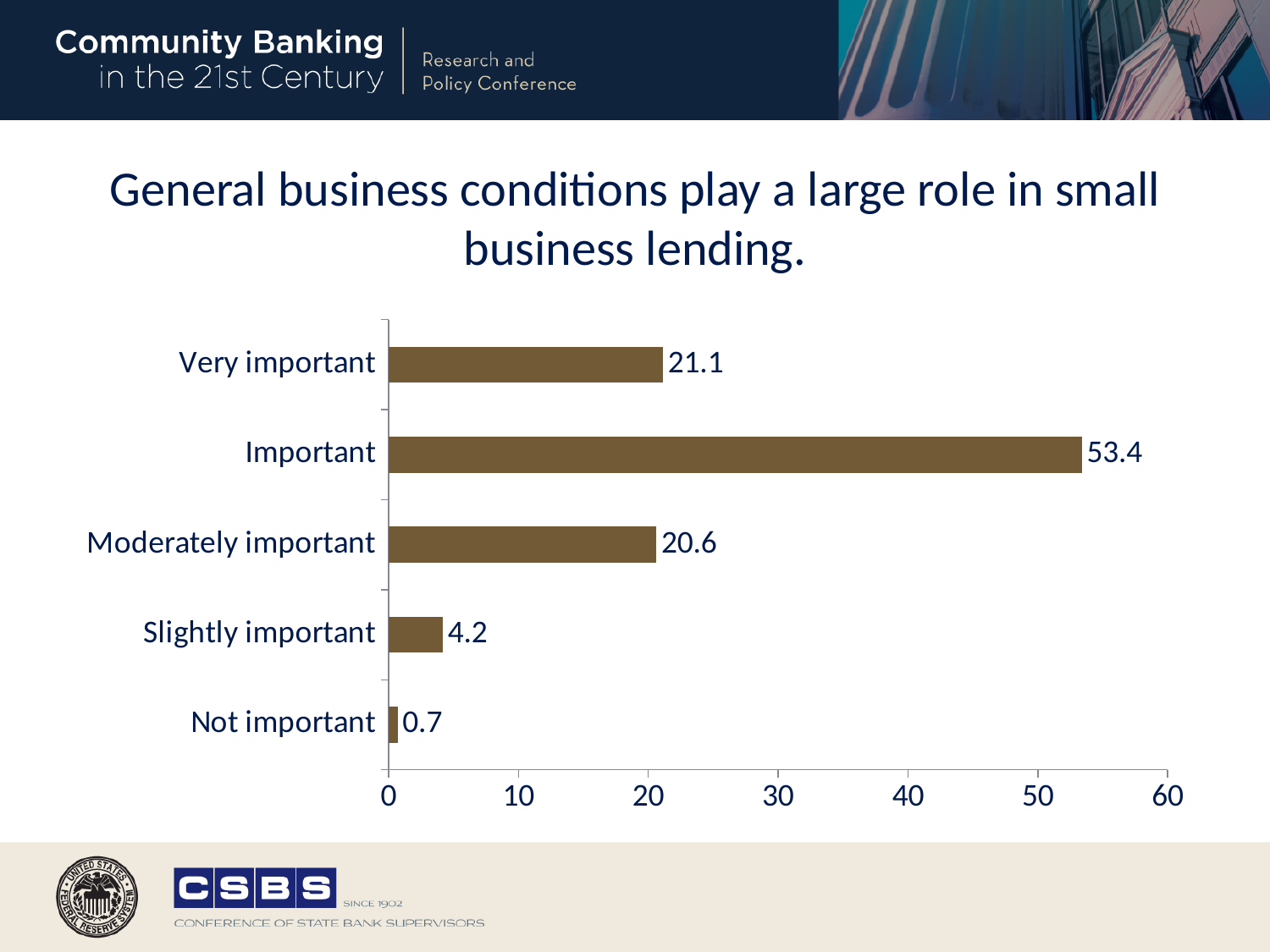
What is the value for Slightly important? 4.2 What is the value for Very important? 21.1 Which category has the highest value? Important Is the value for Important greater or less than 50? greater What is the value for Not important? 0.7 What is the value for Moderately important? 20.6 Which is larger, the value for Slightly important or the value for Not important? Slightly important What is the value for Important? 53.4 Which category has the lowest value? Not important What is the difference between the values for Important and Very important? 32.3 What kind of chart is shown on the slide? bar chart How many categories are shown in the chart? 5